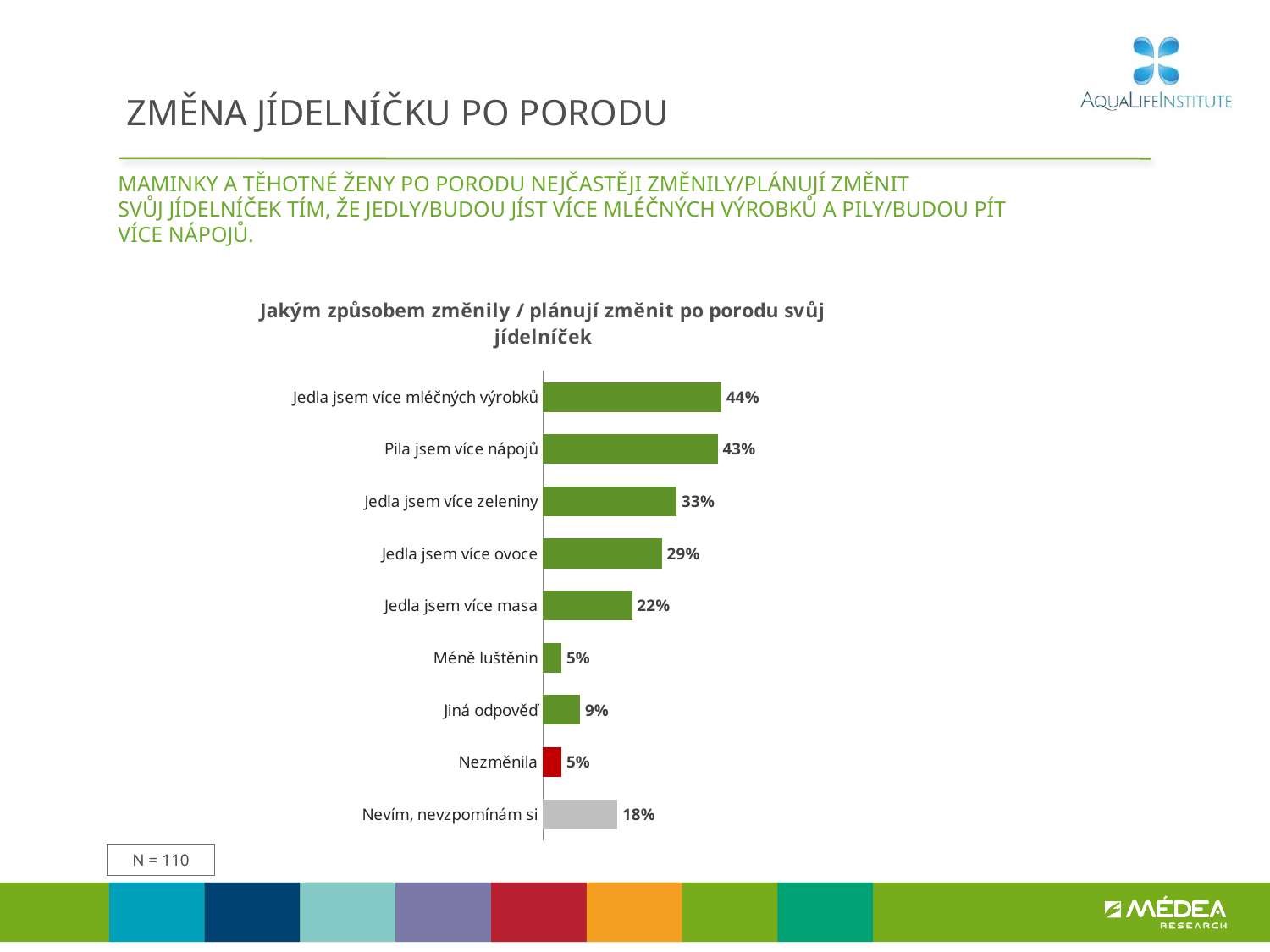
What is the value for "Jedla jsem více mléčných výrobků"? 44% What is the sample size (N) shown on the slide? N = 110 What is the difference between "Jedla jsem více zeleniny" and "Jedla jsem více ovoce"? 4% What is the value for "Jedla jsem více zeleniny"? 33% What kind of chart is shown on the slide? Bar chart Which is larger, "Nevím, nevzpomínám si" or "Jedla jsem více masa"? Jedla jsem více masa Which is larger, "Jiná odpověď" or "Méně luštěnin"? Jiná odpověď How many categories are shown in the chart? 9 What is the value for "Jedla jsem více masa"? 22% What is the value for "Nevím, nevzpomínám si"? 18% Which category has the highest value? Jedla jsem více mléčných výrobků What is the difference between "Pila jsem více nápojů" and "Jedla jsem více masa"? 21%